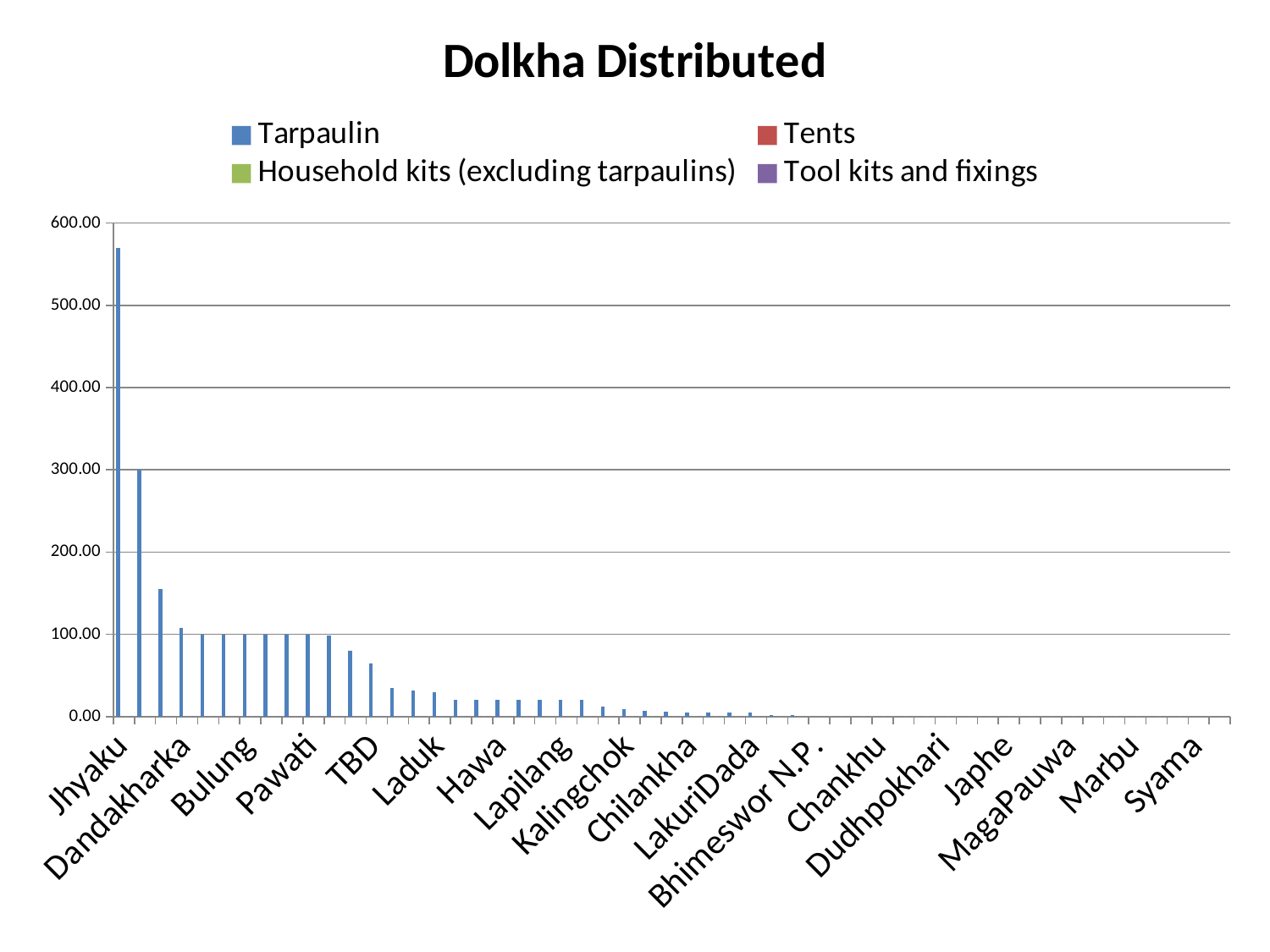
How many series does the legend list? 4 Which category has the highest Tarpaulin value? Jhyaku Is the Tarpaulin value for TBD greater or less than 100.00? less What is the title of the chart? Dolkha Distributed Which has a larger Tarpaulin value, Jhyaku or Dandakharka? Jhyaku Do the Tarpaulin values rise or fall moving from left to right along the x axis? fall Which series is shown in blue in the legend? Tarpaulin Is the Tarpaulin value for Dandakharka greater or less than 100.00? greater Which has a larger Tarpaulin value, Dandakharka or Hawa? Dandakharka What kind of chart is shown on the slide? bar chart Is the Tarpaulin value for Laduk greater or less than 100.00? less